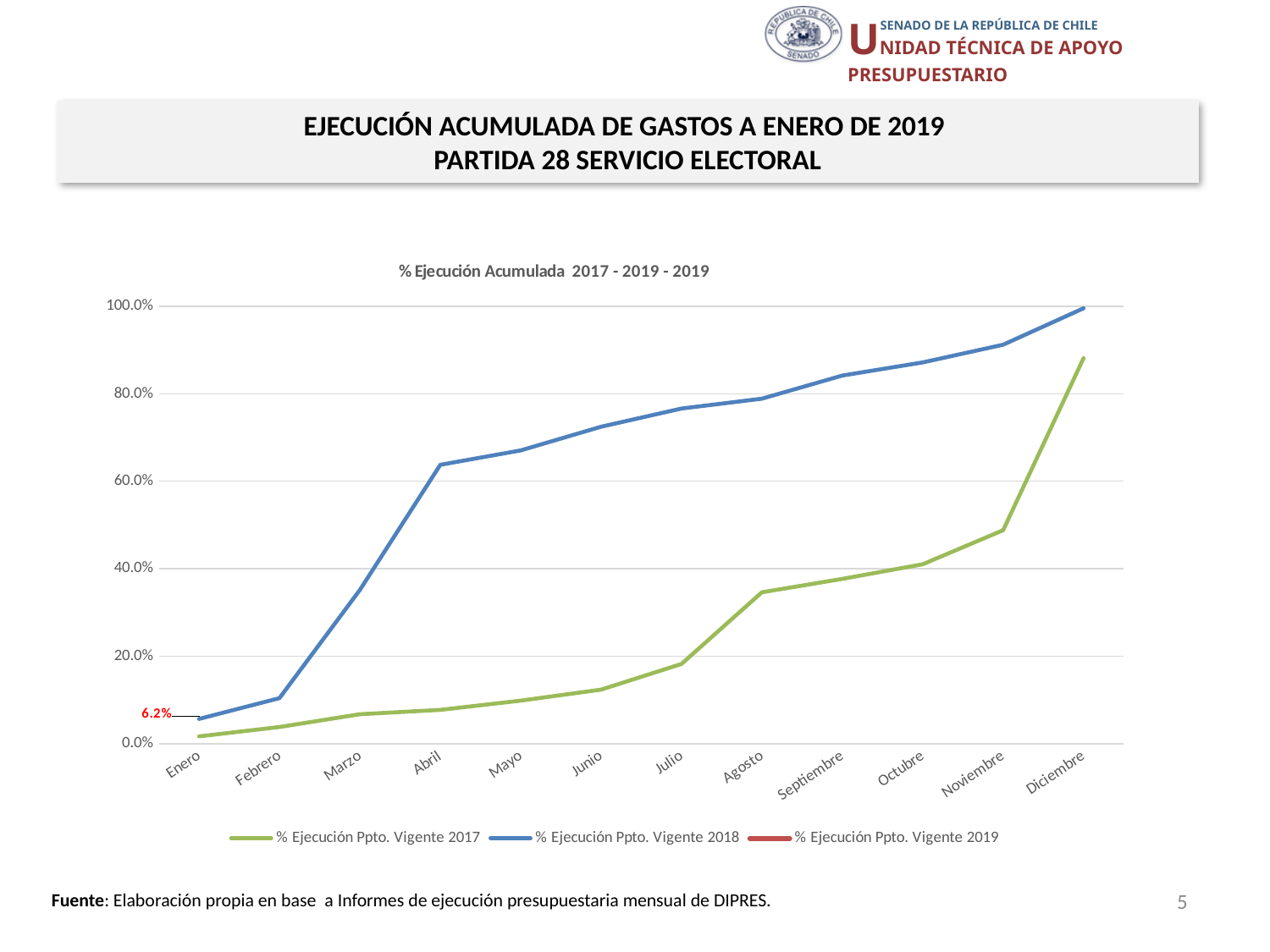
What colour is the line for % Ejecución Ppto. Vigente 2017? green What is the value for % Ejecución Ppto. Vigente 2019 in Enero? 6.2% In which month does % Ejecución Ppto. Vigente 2017 reach its highest value? Diciembre Is the value for % Ejecución Ppto. Vigente 2018 in Abril greater or less than 60.0%? greater How many months are shown along the x axis? 12 In Abril, which series has the larger value, % Ejecución Ppto. Vigente 2017 or % Ejecución Ppto. Vigente 2018? % Ejecución Ppto. Vigente 2018 What is the title of the chart? % Ejecución Acumulada 2017 - 2019 - 2019 Is the value for % Ejecución Ppto. Vigente 2017 in Agosto greater or less than 40.0%? less Do the values for % Ejecución Ppto. Vigente 2018 rise or fall from Enero to Diciembre? rise How many series does the legend list? 3 What kind of chart is shown on the slide? line chart Is the value for % Ejecución Ppto. Vigente 2017 in Diciembre greater or less than 80.0%? greater